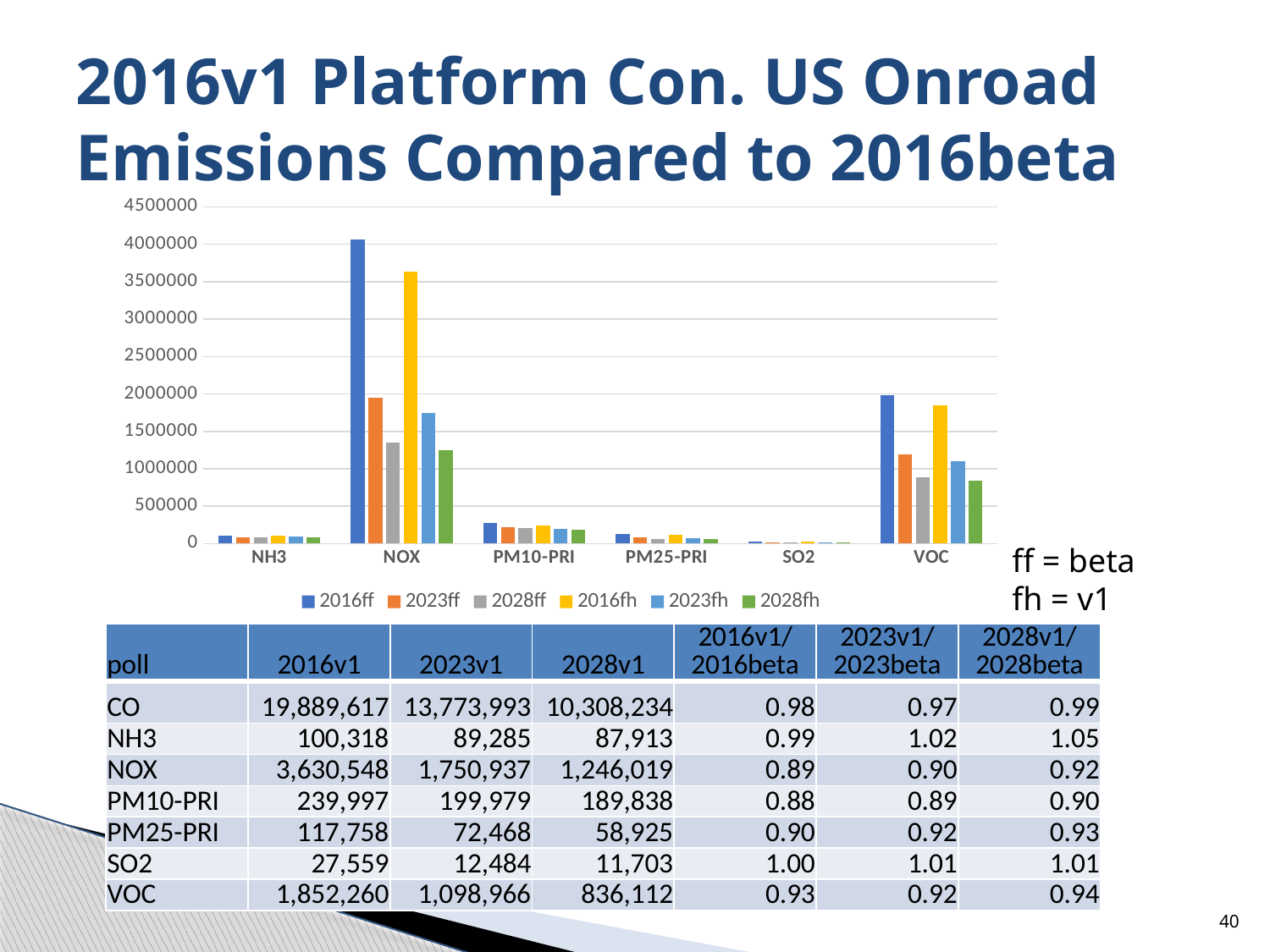
How many pollutant categories are shown on the x axis of the chart? 6 Is the 2016fh value for VOC greater or less than 1500000? greater Which is larger, the 2016ff value for NOX or the 2016ff value for VOC? NOX Is the 2016ff value for NOX greater or less than 3500000? greater Is the 2028fh value for VOC greater or less than 1000000? less According to the note beside the chart, what does the suffix 'ff' in the legend stand for? beta Which pollutant category has the smallest bars in the chart? SO2 What kind of chart is shown on the slide? bar chart Which pollutant category has the tallest bars in the chart? NOX For NOX, which is larger, the 2016ff bar or the 2016fh bar? 2016ff How many series does the chart legend list? 6